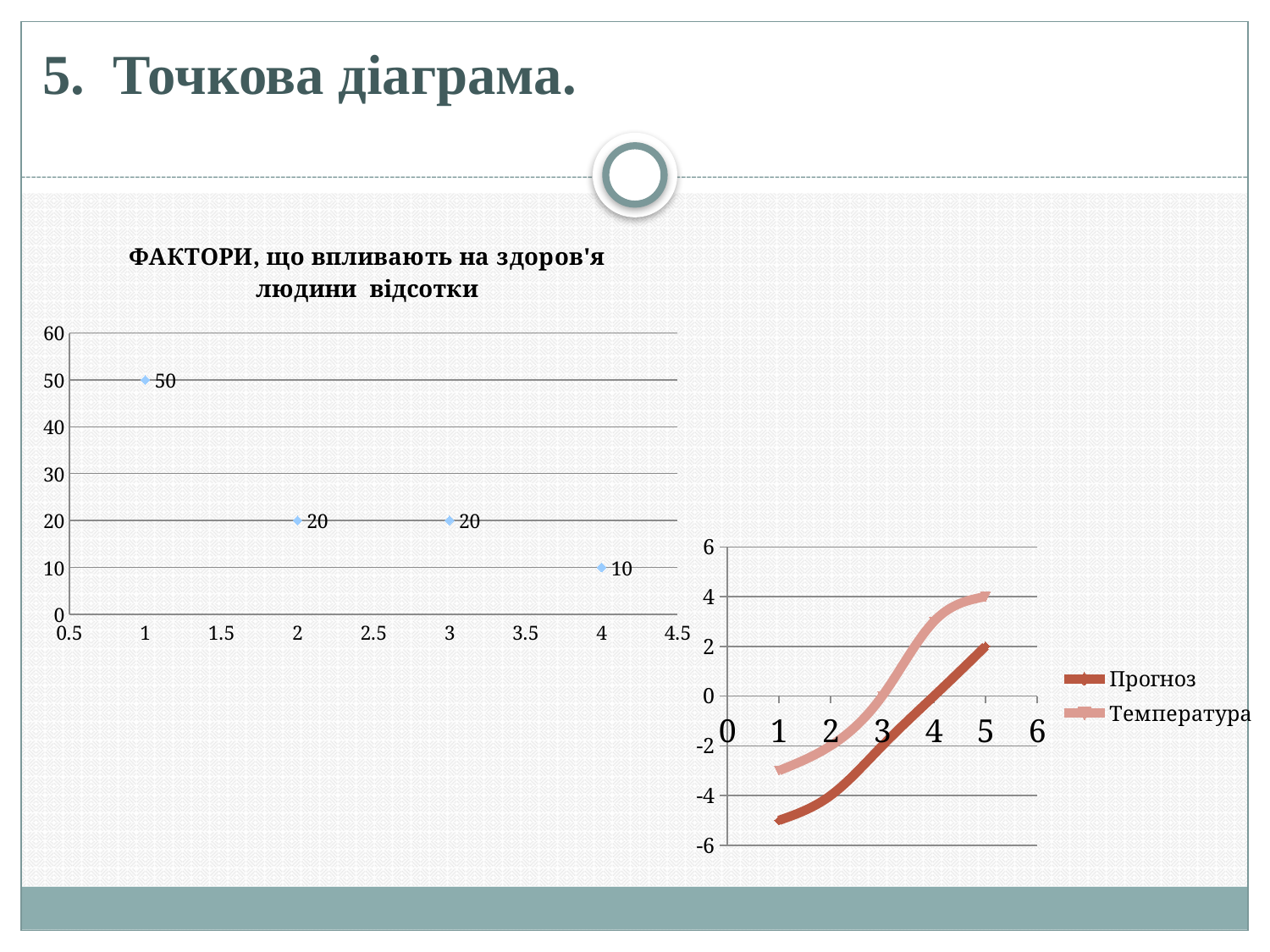
On the chart titled "ФАКТОРИ, що впливають на здоров'я людини відсотки", which x position has the lowest value? 4 On the chart titled "ФАКТОРИ, що впливають на здоров'я людини відсотки", what is the value of the point at x = 2? 20 How many series does the legend of the chart on the right of the slide list? 2 On the chart titled "ФАКТОРИ, що впливають на здоров'я людини відсотки", what is the difference between the value at x = 1 and the value at x = 4? 40 On the chart titled "ФАКТОРИ, що впливають на здоров'я людини відсотки", what is the value of the point at x = 4? 10 On the chart titled "ФАКТОРИ, що впливають на здоров'я людини відсотки", do the values rise or fall as x increases? fall On the chart on the right of the slide, at x = 3, which series has the larger value, Прогноз or Температура? Температура On the chart titled "ФАКТОРИ, що впливають на здоров'я людини відсотки", what is the value of the point at x = 1? 50 On the chart titled "ФАКТОРИ, що впливають на здоров'я людини відсотки", which x position has the highest value? 1 On the chart on the right of the slide, is the value of Прогноз at x = 1 greater or less than -4? less On the chart on the right of the slide, is the value of Температура at x = 4 greater or less than 2? greater On the chart titled "ФАКТОРИ, що впливають на здоров'я людини відсотки", how many data points are plotted? 4